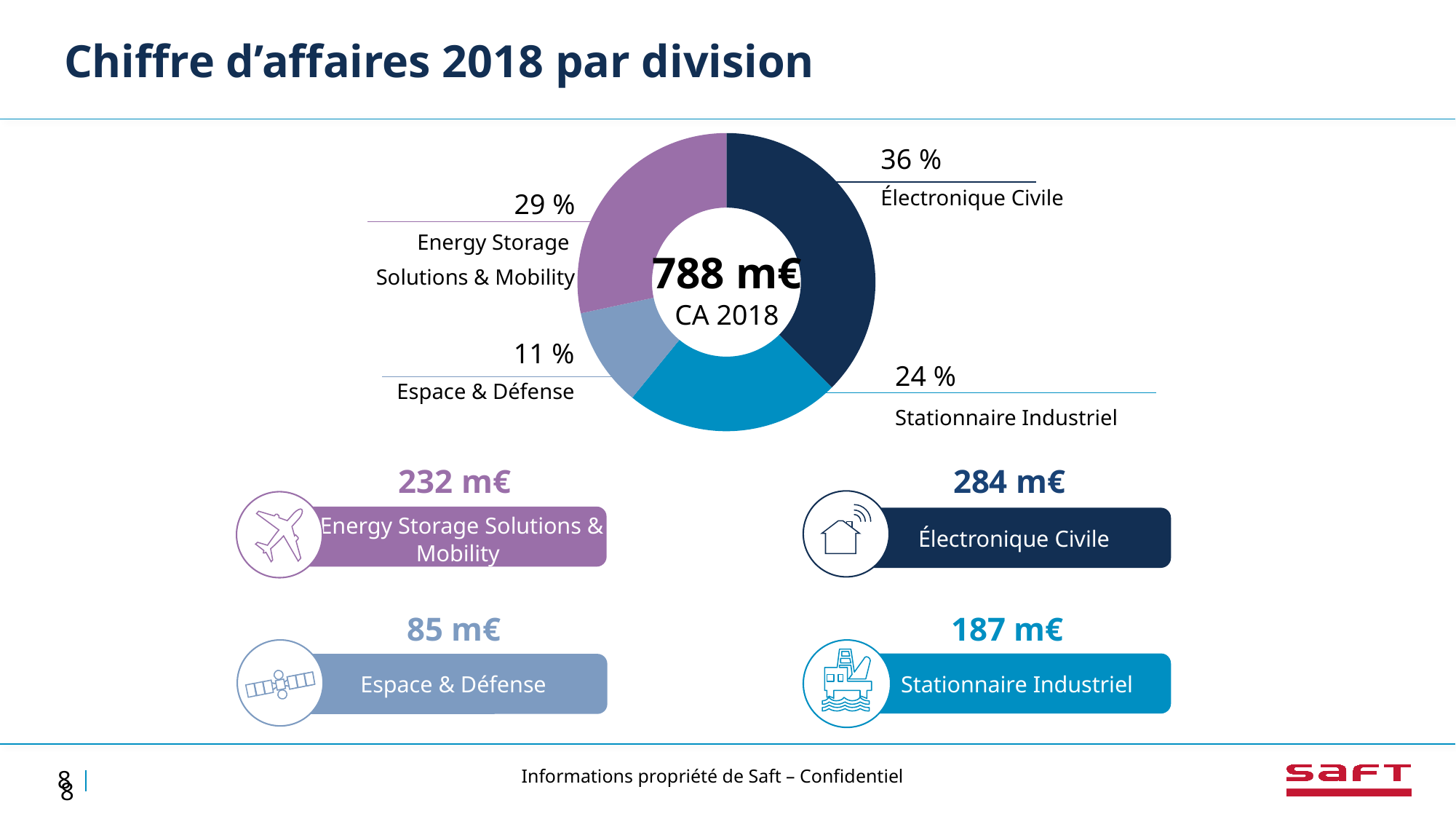
What share of the 2018 revenue does Électronique Civile represent in the donut chart? 36 % What percentage is shown for Stationnaire Industriel in the donut chart? 24 % What is the difference in percentage points between Électronique Civile and Stationnaire Industriel? 12 % What total value is shown in the centre of the donut chart? 788 m€ Which division has the largest share of the 2018 revenue? Électronique Civile Which division has the smallest share of the 2018 revenue? Espace & Défense Which has a larger share, Energy Storage Solutions & Mobility or Stationnaire Industriel? Energy Storage Solutions & Mobility What share of the 2018 revenue does Espace & Défense represent in the donut chart? 11 % What is the title of the slide containing the chart? Chiffre d’affaires 2018 par division How many divisions are shown in the donut chart? 4 What percentage is shown for Energy Storage Solutions & Mobility in the donut chart? 29 % What type of chart is used to show the 2018 revenue by division? Donut (pie) chart